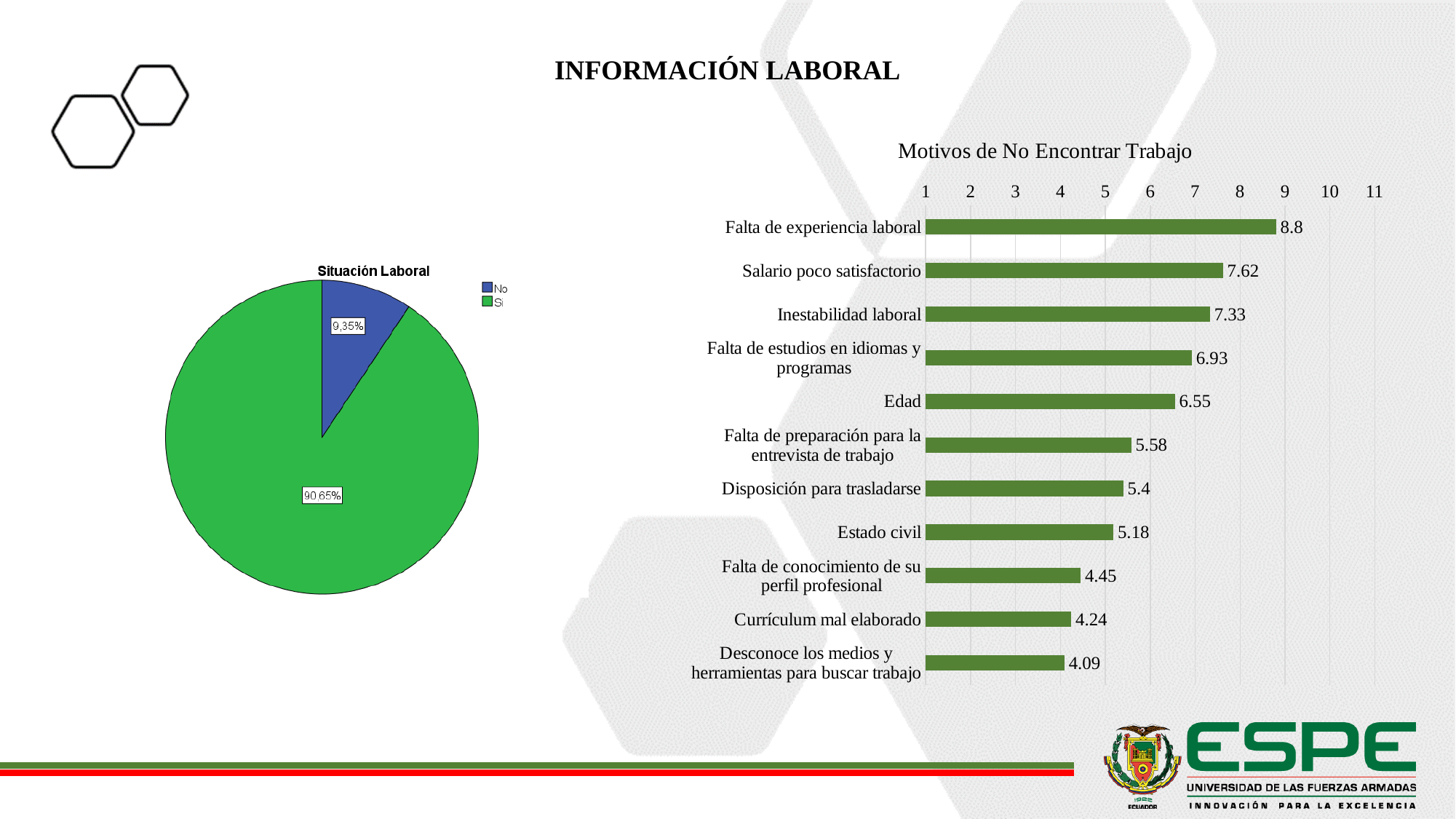
In the 'Motivos de No Encontrar Trabajo' chart, what is the value for Falta de experiencia laboral? 8.8 In the 'Motivos de No Encontrar Trabajo' chart, what is the value for Edad? 6.55 In the 'Situación Laboral' pie chart, what share does 'Si' have? 90,65% What kind of chart is 'Situación Laboral'? Pie chart In the 'Motivos de No Encontrar Trabajo' chart, what is the difference between Salario poco satisfactorio and Inestabilidad laboral? 0.29 In the 'Situación Laboral' pie chart, what is the value for 'No'? 9,35% What kind of chart is 'Motivos de No Encontrar Trabajo'? Bar chart How many categories are shown in the 'Motivos de No Encontrar Trabajo' chart? 11 In the 'Motivos de No Encontrar Trabajo' chart, which is larger: Estado civil or Currículum mal elaborado? Estado civil In the 'Motivos de No Encontrar Trabajo' chart, which category has the highest value? Falta de experiencia laboral In the 'Motivos de No Encontrar Trabajo' chart, which category has the lowest value? Desconoce los medios y herramientas para buscar trabajo How many entries does the legend of the 'Situación Laboral' chart list? 2